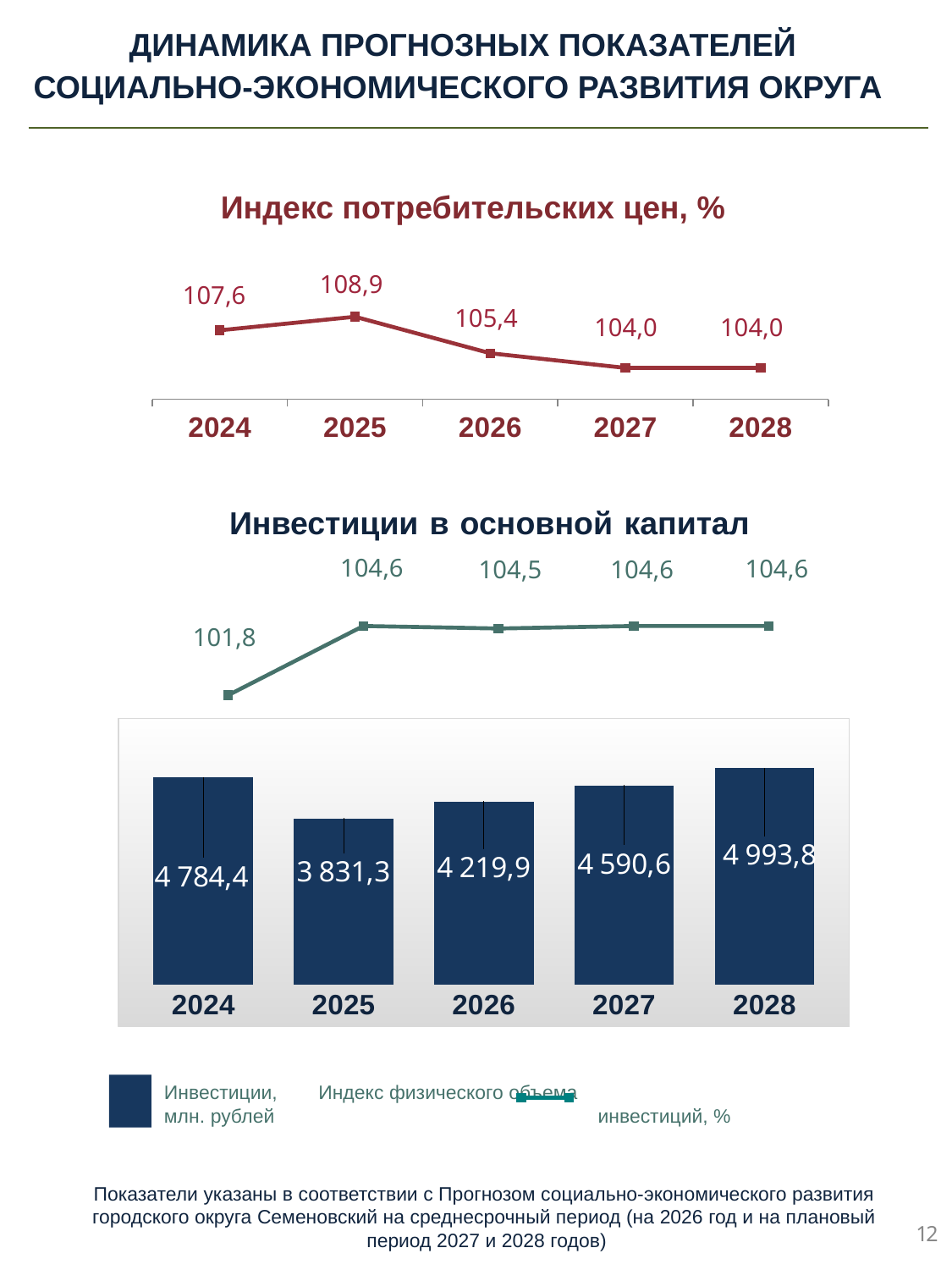
In the chart 'Индекс потребительских цен, %', how many years are plotted? 5 In the chart 'Инвестиции в основной капитал', which year has the highest investment value (млн. рублей)? 2028 In the chart 'Инвестиции в основной капитал', what is the difference between the investment values for 2028 and 2025 (млн. рублей)? 1 162,5 In the chart 'Инвестиции в основной капитал', what is the value of the index of physical volume of investments (%) for 2024? 101,8 In the chart 'Индекс потребительских цен, %', do the values rise or fall from 2025 to 2027? fall In the chart 'Индекс потребительских цен, %', what is the value for 2025? 108,9 In the chart 'Индекс потребительских цен, %', which year has the highest value? 2025 In the chart 'Инвестиции в основной капитал', which year has the lowest investment value (млн. рублей)? 2025 In the chart 'Инвестиции в основной капитал', which is larger: the investment value for 2024 or for 2026? 2024 In the chart 'Инвестиции в основной капитал', how many series does the legend list? 2 In the chart 'Индекс потребительских цен, %', what is the difference between the 2025 value and the 2026 value? 3,5 In the chart 'Инвестиции в основной капитал', what is the investment value (млн. рублей) for 2027? 4 590,6